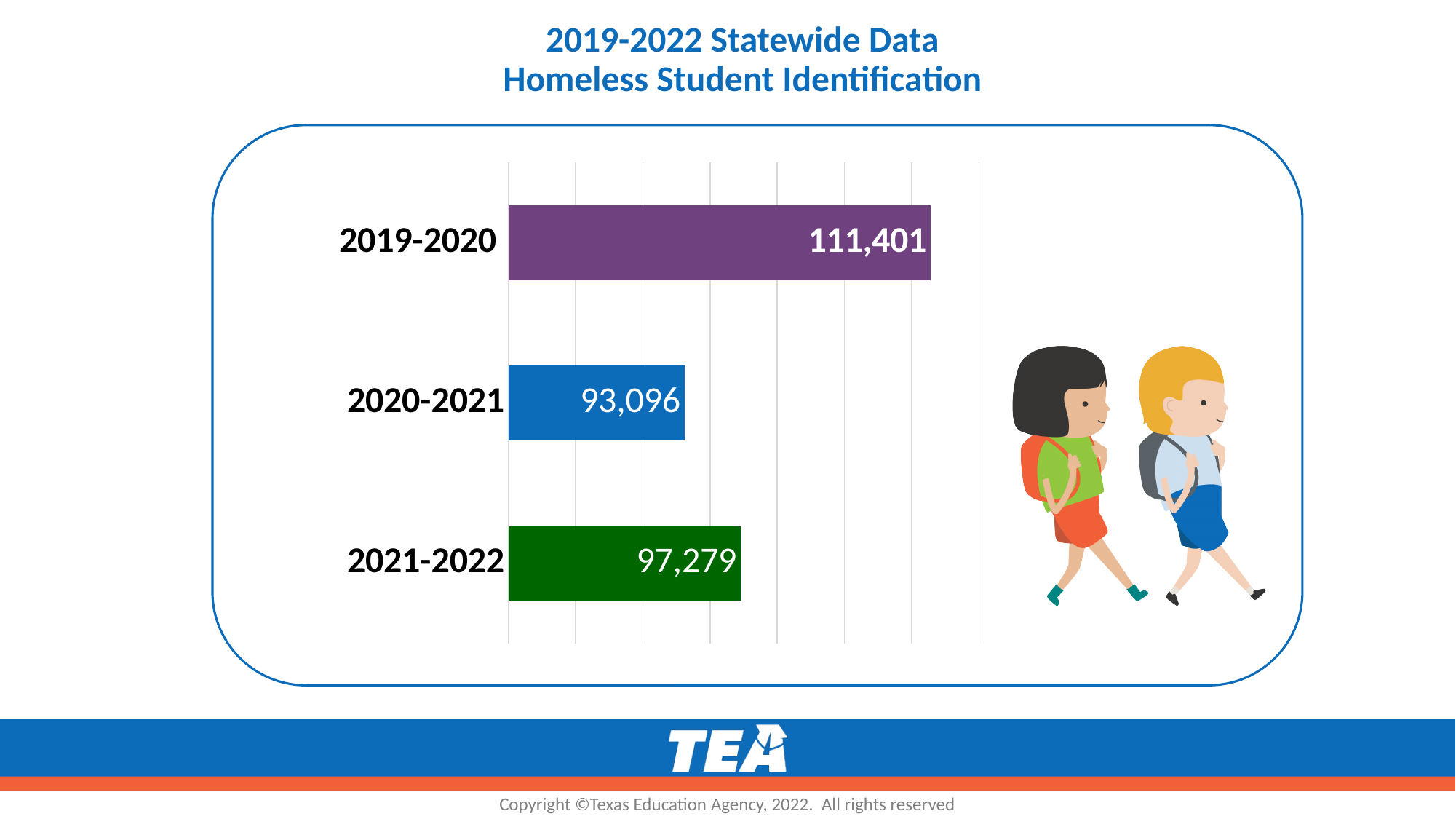
Which school year has the highest value? 2019-2020 What kind of chart is shown on the slide? Bar chart What is the difference between the values for 2021-2022 and 2020-2021? 4,183 How many school years are shown in the chart? 3 Which is larger, the value for 2020-2021 or the value for 2021-2022? 2021-2022 What colour is the bar for 2021-2022? Green What is the value for 2019-2020? 111,401 What is the value for 2020-2021? 93,096 What is the value for 2021-2022? 97,279 What is the difference between the values for 2019-2020 and 2020-2021? 18,305 What is the title of the chart? 2019-2022 Statewide Data Homeless Student Identification Which school year has the lowest value? 2020-2021